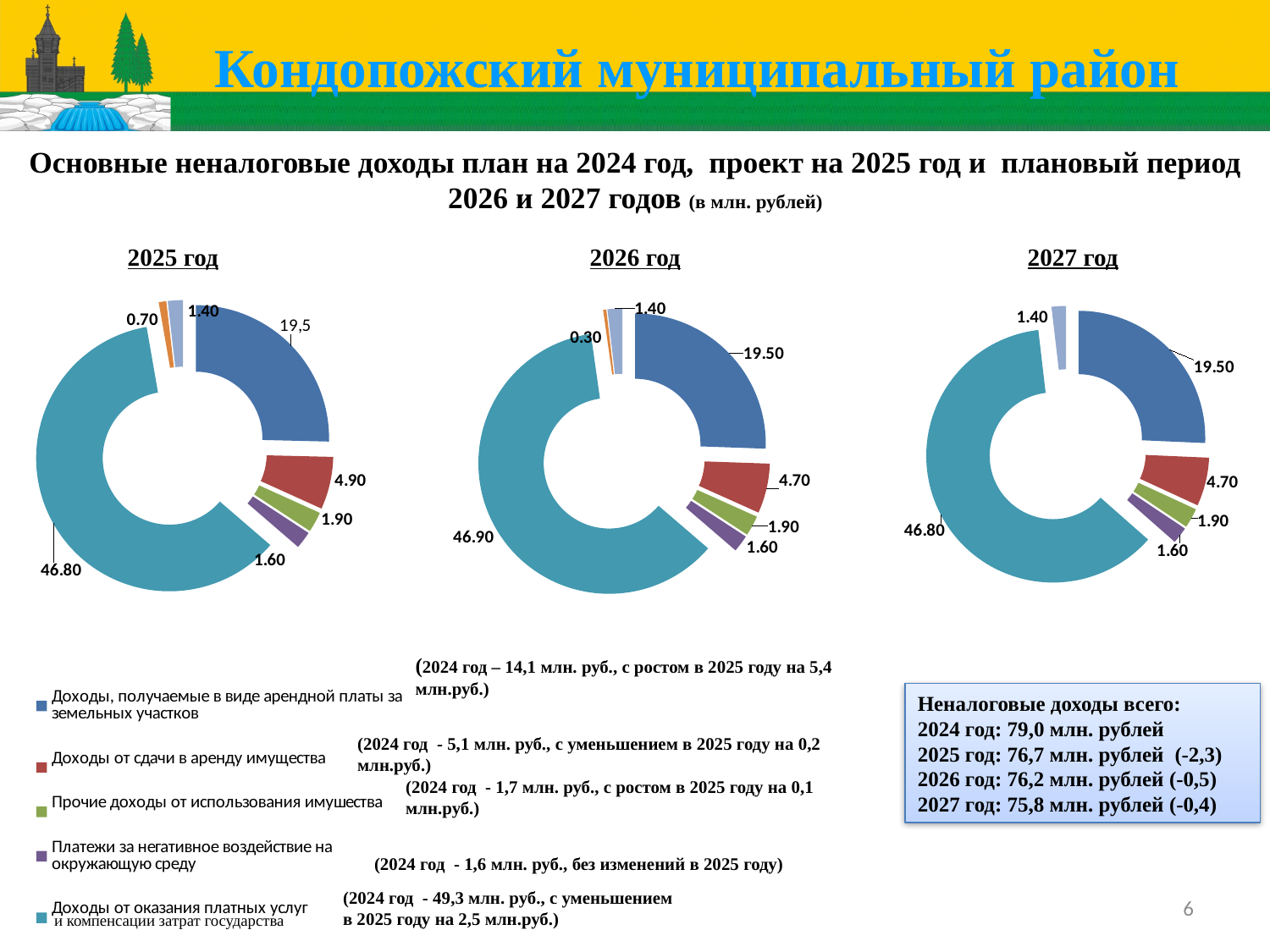
How many categories does the legend list? 5 On the 2026 год chart, what is the difference between the value for Доходы от оказания платных услуг и компенсации затрат государства (46.90) and the value for Доходы, получаемые в виде арендной платы за земельных участков (19.50)? 27.40 On the 2025 год chart, which legend category has the largest slice? Доходы от оказания платных услуг и компенсации затрат государства Which colour represents Платежи за негативное воздействие на окружающую среду in the legend? Purple On the 2025 год chart, what is the value of the smallest labelled slice? 0.70 On the 2027 год chart, which is larger: Прочие доходы от использования имущества or Платежи за негативное воздействие на окружающую среду? Прочие доходы от использования имущества What kind of chart is used for each year on this slide? Doughnut (pie) chart On the 2026 год chart, what is the value for Доходы, получаемые в виде арендной платы за земельных участков? 19.50 On the 2027 год chart, what is the value for Доходы от сдачи в аренду имущества? 4.70 On the 2026 год chart, what is the smallest labelled value? 0.30 How many slices does the 2027 год chart have? 6 On the 2025 год chart, what is the value of the largest slice (Доходы от оказания платных услуг и компенсации затрат государства)? 46.80